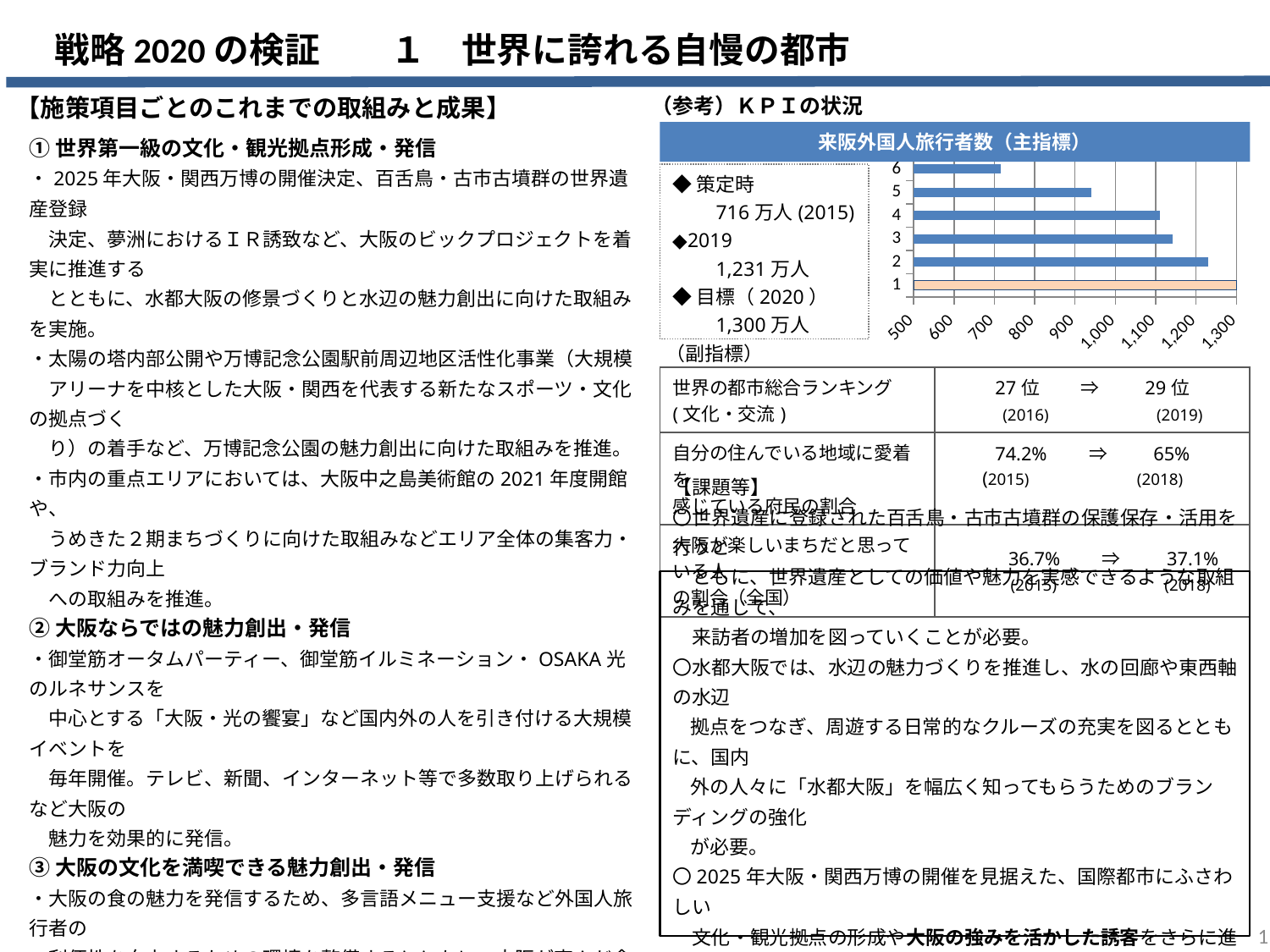
In the 来阪外国人旅行者数 chart, is the value for category 3 greater or less than 1,100? greater How many categories are plotted on the y axis of the 来阪外国人旅行者数 chart? 6 In the 来阪外国人旅行者数 chart, which has the larger value, category 2 or category 5? 2 In the 来阪外国人旅行者数 chart, do the bar values increase or decrease going from category 6 down to category 1? increase In the 来阪外国人旅行者数 chart, is the value for category 5 greater or less than 900? greater In the 来阪外国人旅行者数 chart, which category's bar is coloured differently (orange) from the blue bars? 1 Which category has the shortest bar in the 来阪外国人旅行者数 chart? 6 In the 来阪外国人旅行者数 chart, is the value for category 2 greater or less than 1,200? greater What kind of chart is shown under the title 来阪外国人旅行者数（主指標）? bar chart Which category has the longest bar in the 来阪外国人旅行者数 chart? 1